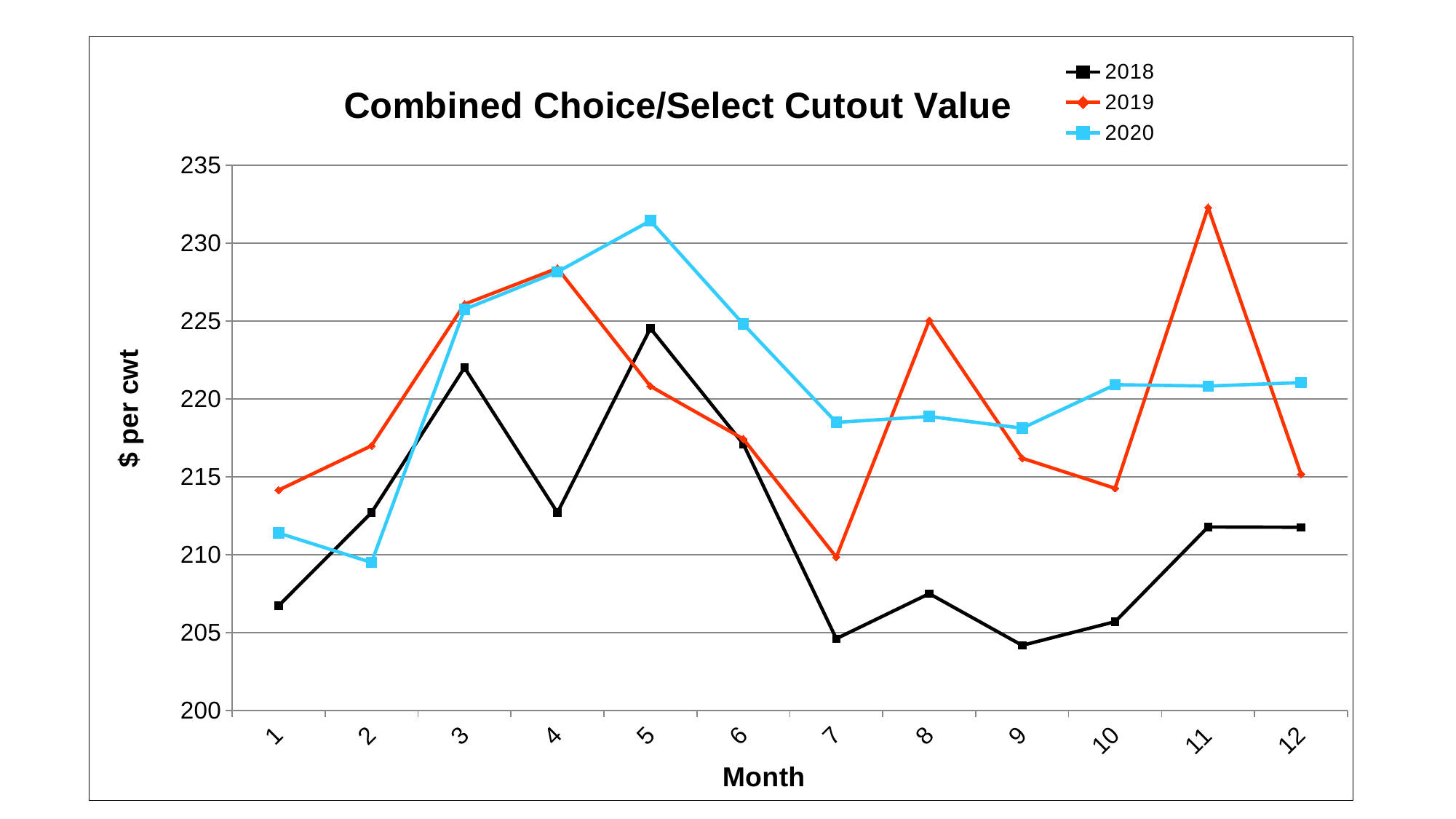
In month 12, which series has the higher value, 2019 or 2020? 2020 In month 8, which series has the higher value, 2018 or 2019? 2019 How many series does the legend list? 3 In which month does the 2019 series reach its lowest value? 7 Is the value for 2018 in month 7 greater or less than 205? less In which month does the 2018 series reach its highest value? 5 What kind of chart is shown on the slide? line chart In which month does the 2020 series reach its highest value? 5 What is the label on the y axis? $ per cwt In which month does the 2019 series reach its highest value? 11 Is the value for 2019 in month 11 greater or less than 230? greater How many months are plotted along the x axis? 12